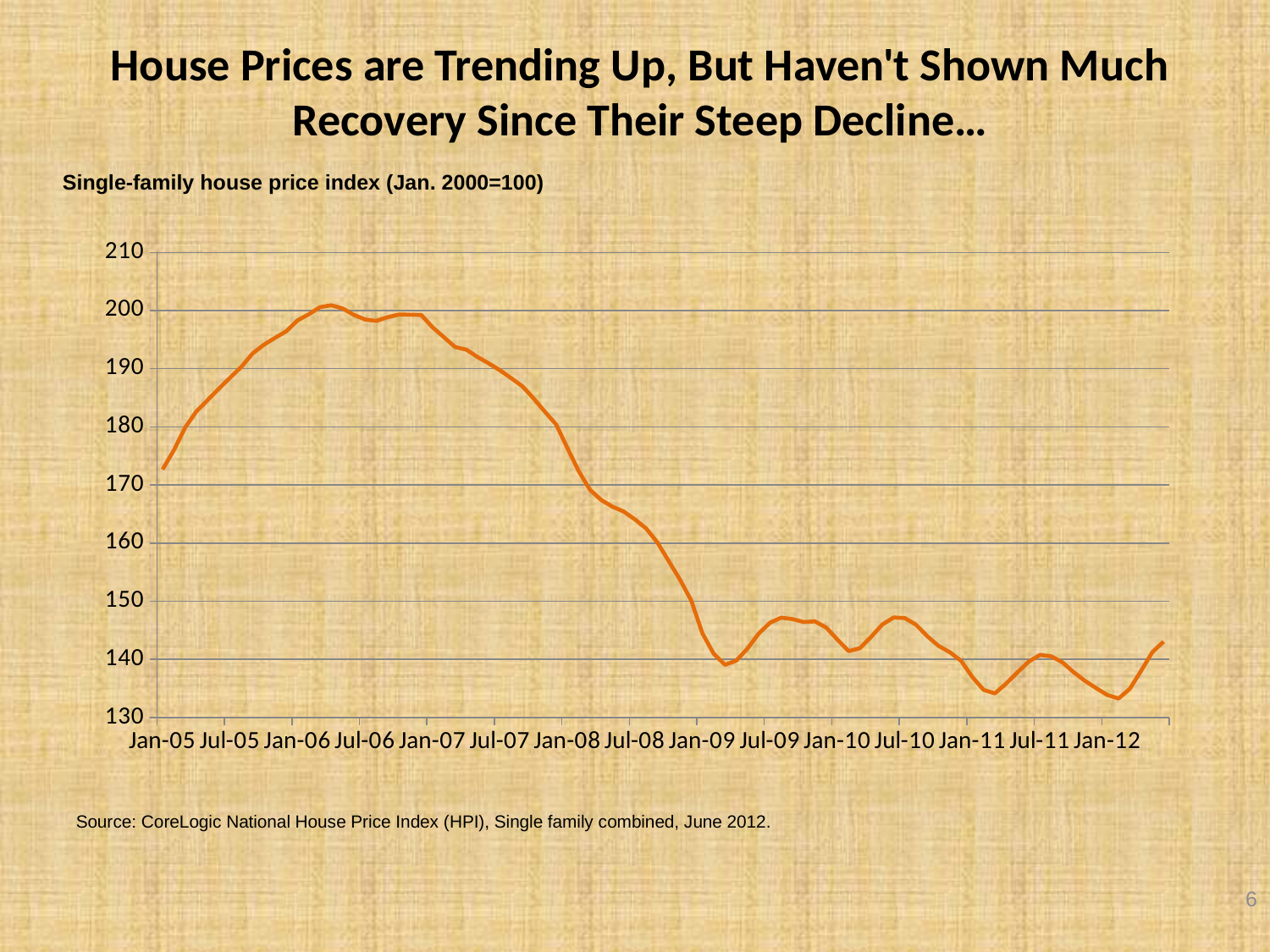
Is the house price index value for Jan-05 greater or less than 180? less How many date labels are shown on the x axis? 15 Is the house price index value for Jul-08 greater or less than 170? less What is the highest value shown on the y axis? 210 Is the house price index value for Jan-12 greater or less than 140? less Does the house price index rise or fall overall between Jan-07 and Jan-09? Fall What kind of chart is shown on the slide? Line chart Which is larger, the house price index at Jan-06 or at Jan-09? Jan-06